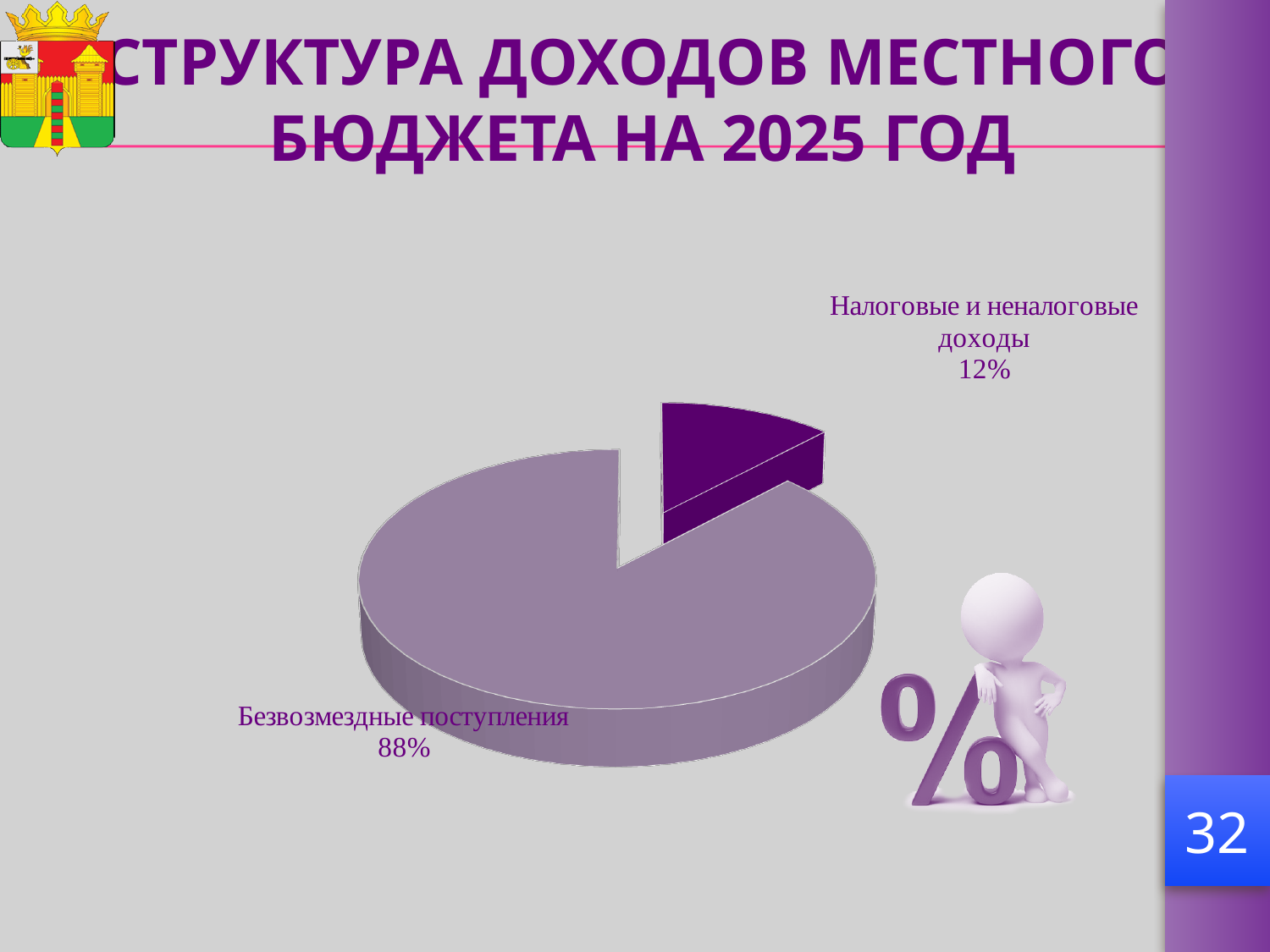
Which category has the largest slice of the pie? Безвозмездные поступления What is the title of the slide containing the chart? СТРУКТУРА ДОХОДОВ МЕСТНОГО БЮДЖЕТА НА 2025 ГОД Which is larger: Безвозмездные поступления or Налоговые и неналоговые доходы? Безвозмездные поступления Which category has the smallest slice of the pie? Налоговые и неналоговые доходы How many categories are shown in the pie chart? 2 What share of the pie does Налоговые и неналоговые доходы have? 12% Which slice is pulled out (exploded) from the pie? Налоговые и неналоговые доходы What share of the pie does Безвозмездные поступления have? 88% What kind of chart is shown on the slide? Pie chart What is the difference in percentage points between Безвозмездные поступления and Налоговые и неналоговые доходы? 76